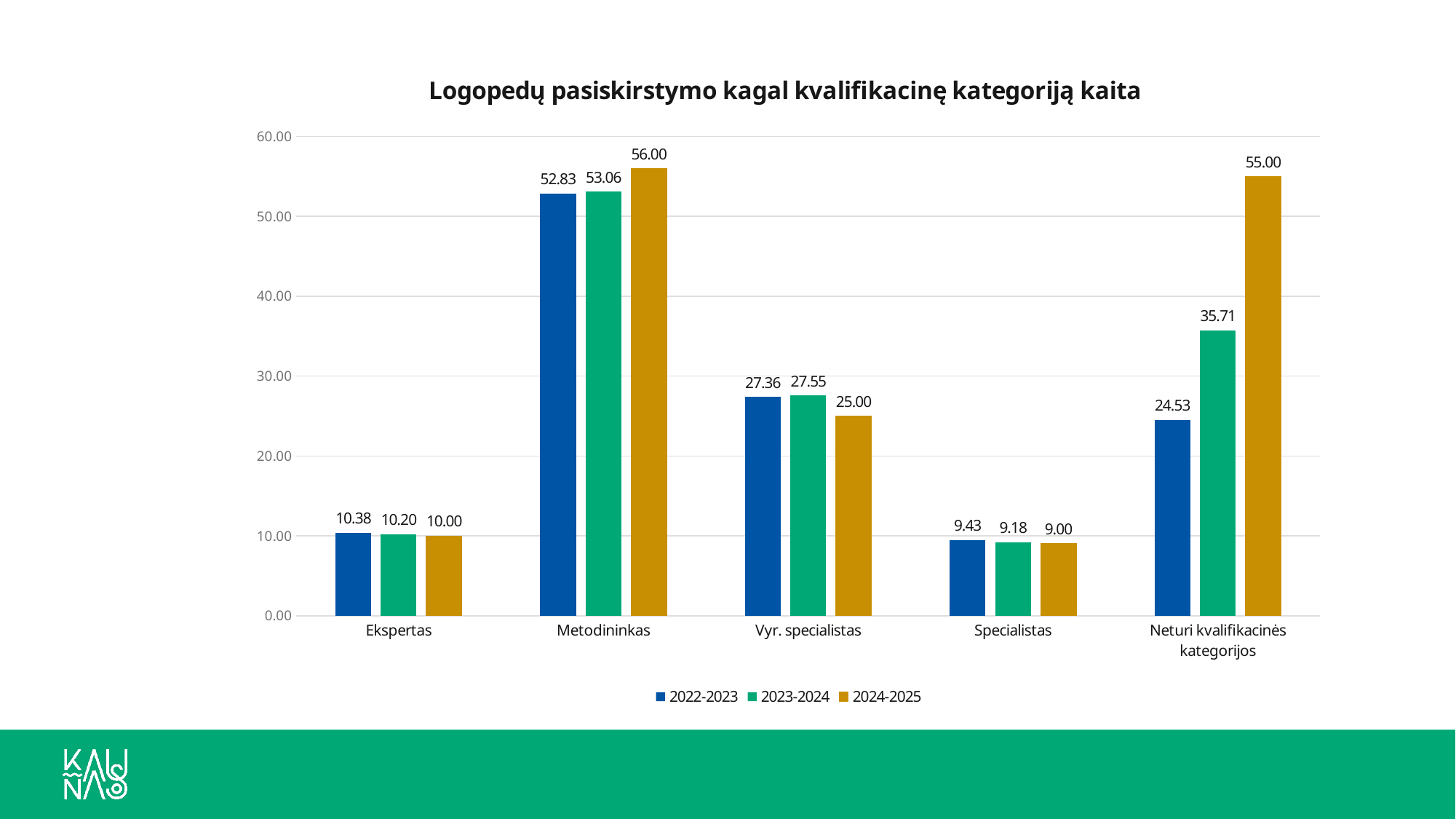
What kind of chart is shown on the slide? bar chart What is the value for Neturi kvalifikacinės kategorijos in the 2022-2023 series? 24.53 Which is larger for Ekspertas: the 2022-2023 value or the 2024-2025 value? 2022-2023 What is the difference between the 2024-2025 and 2022-2023 values for Neturi kvalifikacinės kategorijos? 30.47 How many series does the legend list? 3 How many categories are shown on the x axis? 5 Is the 2023-2024 value for Neturi kvalifikacinės kategorijos greater or less than 30.00? greater What is the title of the chart? Logopedų pasiskirstymo kagal kvalifikacinę kategoriją kaita What is the value for Metodininkas in the 2024-2025 series? 56.00 What is the value for Vyr. specialistas in the 2023-2024 series? 27.55 Which category has the highest value in the 2022-2023 series? Metodininkas Which category has the lowest value in the 2024-2025 series? Specialistas